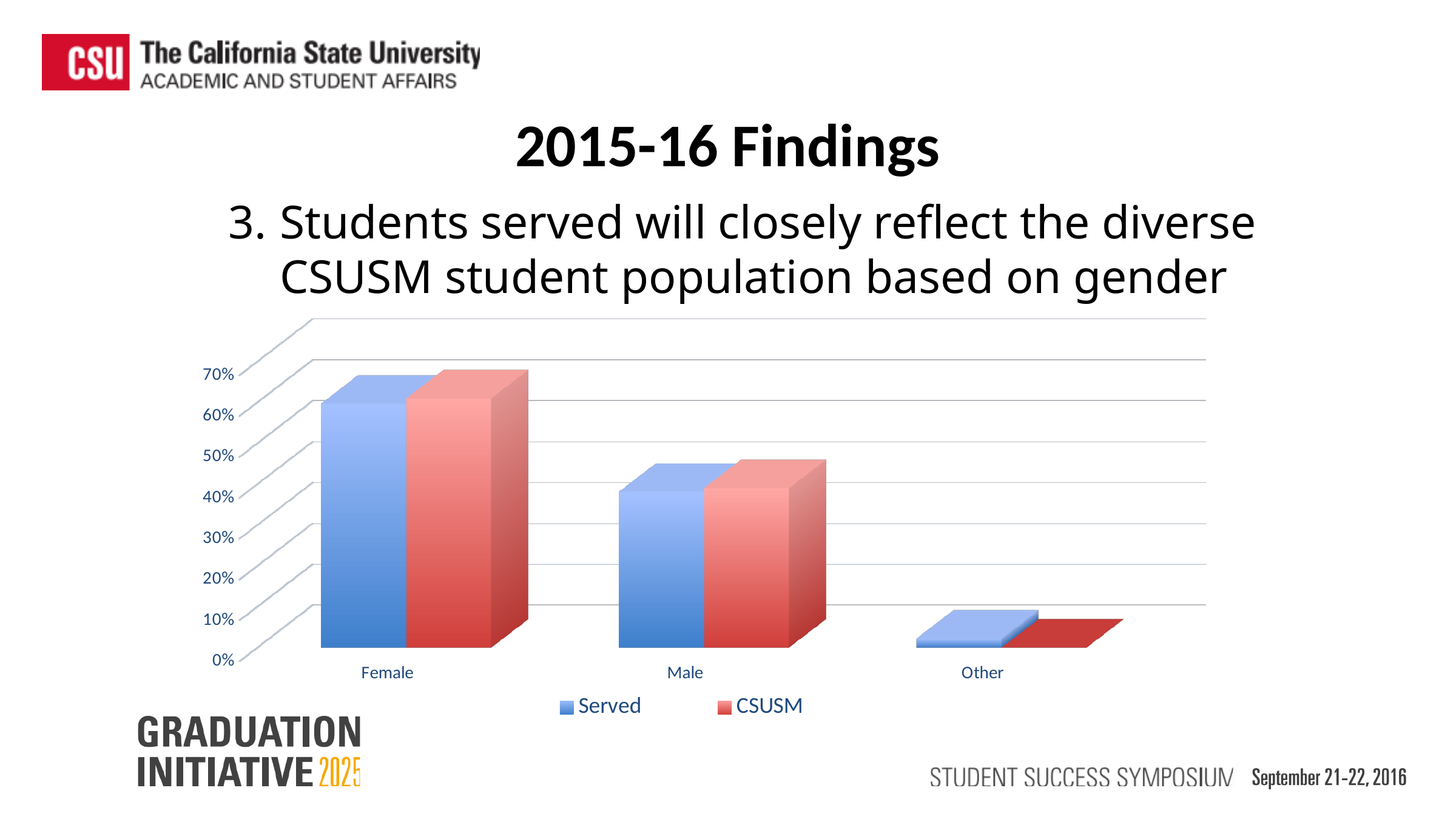
Which series is shown in red in the chart? CSUSM For the CSUSM series, which is larger: Male or Other? Male For the Served series, which is larger: Female or Male? Female Which category has the lowest value for the CSUSM series? Other Is the Served value for Other greater or less than 10%? less How many series does the chart's legend list? 2 What kind of chart is shown on the slide? bar chart Is the CSUSM value for Female greater or less than 50%? greater Is the Served value for Male greater or less than 50%? less Which category has the highest value for the Served series? Female How many categories are shown on the x axis of the chart? 3